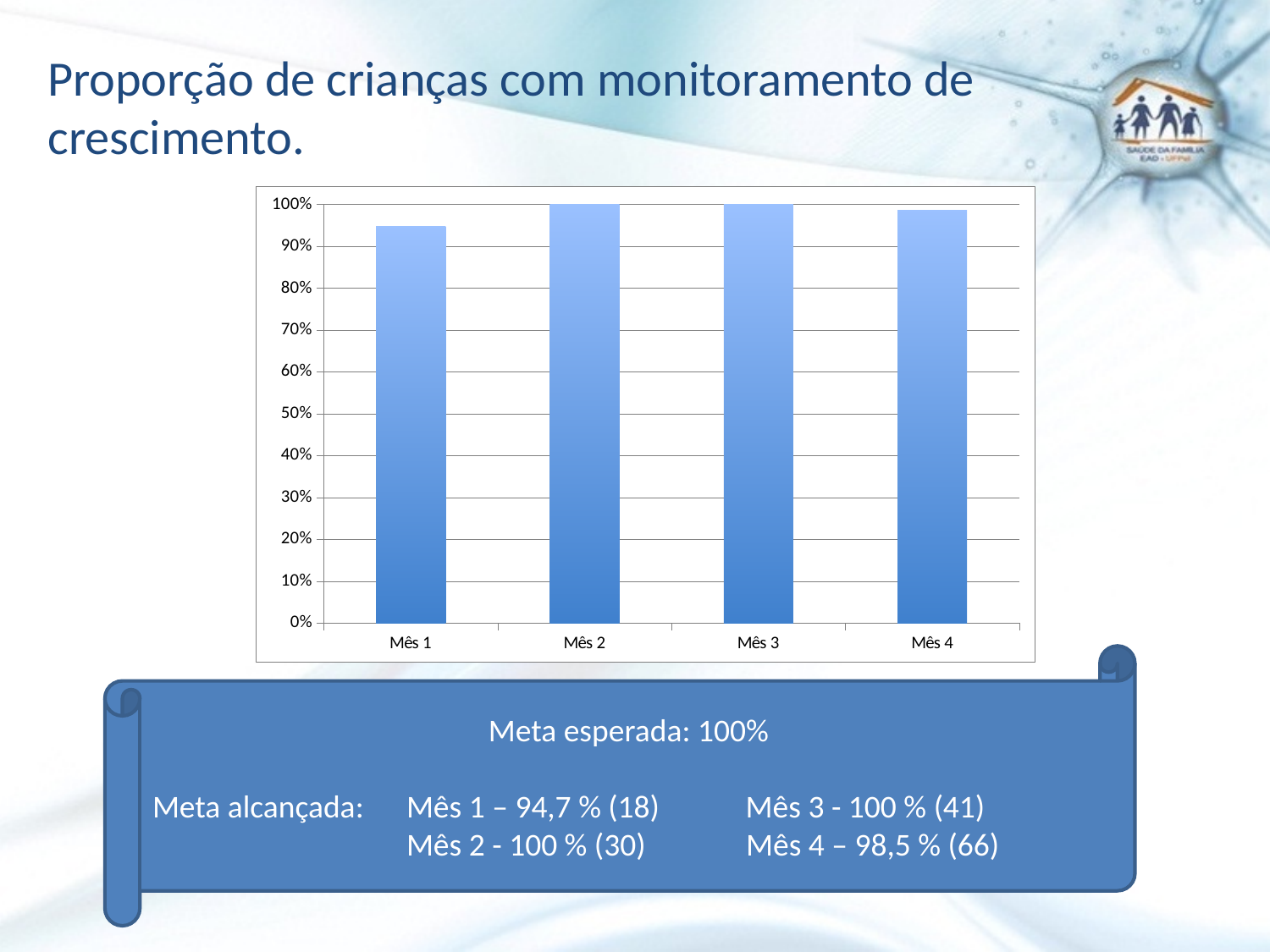
Which is larger, the value for Mês 1 or the value for Mês 4? Mês 4 Does the value rise or fall from Mês 1 to Mês 2? rise How many months (categories) are shown on the x axis of the chart? 4 According to the text box on the slide, what proportion was achieved in Mês 1? 94,7 % What kind of chart is shown on the slide? bar chart Is the value for Mês 1 greater or less than 90%? greater What value does the bar for Mês 3 reach on the y axis? 100% According to the text box below the chart, what is the expected target (Meta esperada)? 100% What value does the bar for Mês 2 reach on the y axis? 100% What is the title of the slide above the chart? Proporção de crianças com monitoramento de crescimento. Which month has the lowest bar in the chart? Mês 1 According to the text box on the slide, what proportion was achieved in Mês 4? 98,5 %